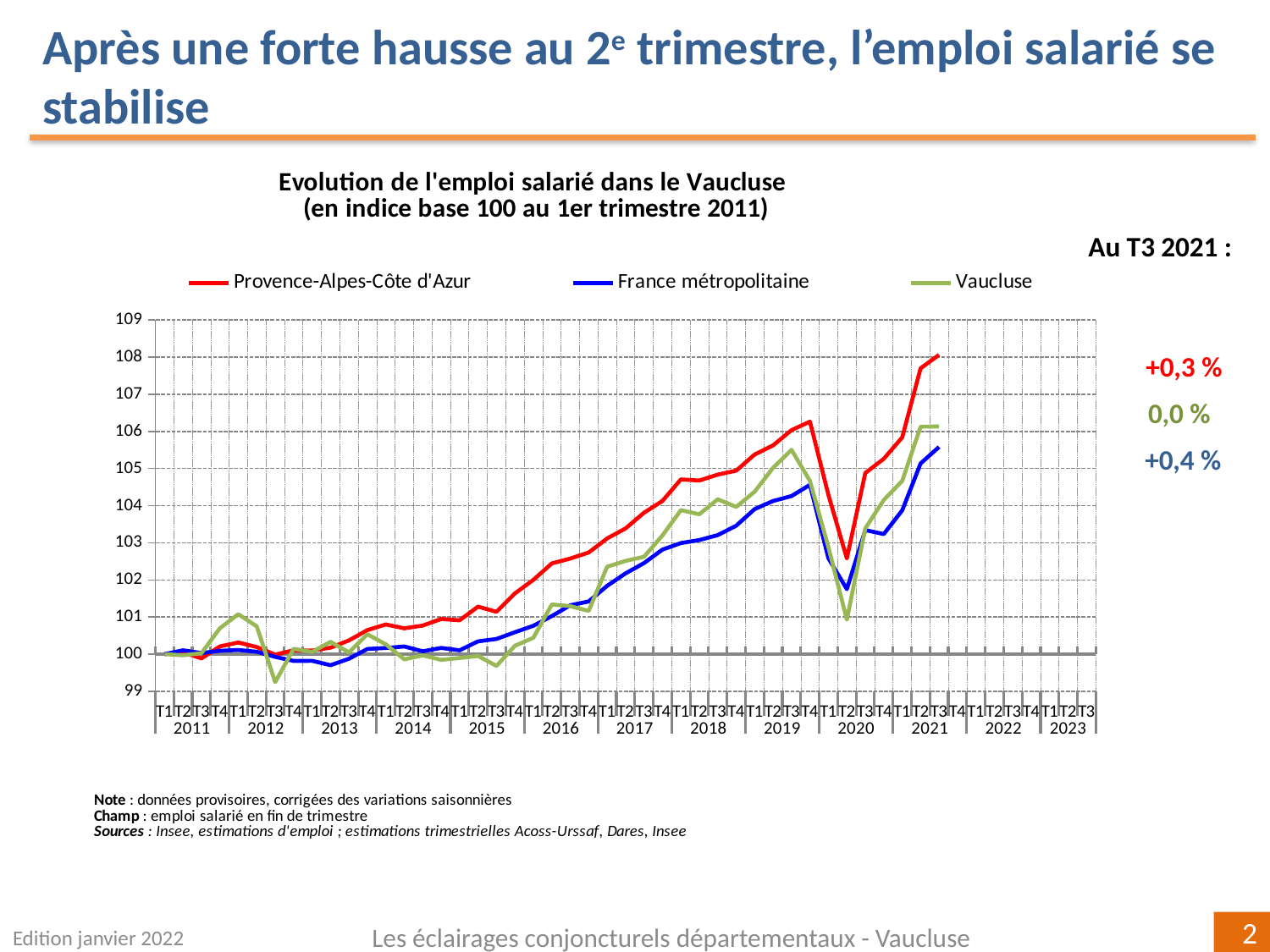
What kind of chart is shown on the slide? Line chart At T2 2020, which series is lower: Vaucluse or France métropolitaine? Vaucluse Which series is drawn in red? Provence-Alpes-Côte d'Azur Is the value for Vaucluse at T2 2020 greater or less than 102? less How many series does the legend list? 3 Which series has the lowest value at T3 2012? Vaucluse Is the value for Provence-Alpes-Côte d'Azur at T3 2021 greater or less than 107? greater Is the value for France métropolitaine at T2 2020 greater or less than 103? less What is the title of the chart? Evolution de l'emploi salarié dans le Vaucluse (en indice base 100 au 1er trimestre 2011) Between T1 2015 and T3 2019, does the Provence-Alpes-Côte d'Azur line rise or fall? rise According to the annotation on the right, what is the change shown for Vaucluse at T3 2021? 0,0 % At T3 2021, which series is higher: Provence-Alpes-Côte d'Azur or France métropolitaine? Provence-Alpes-Côte d'Azur